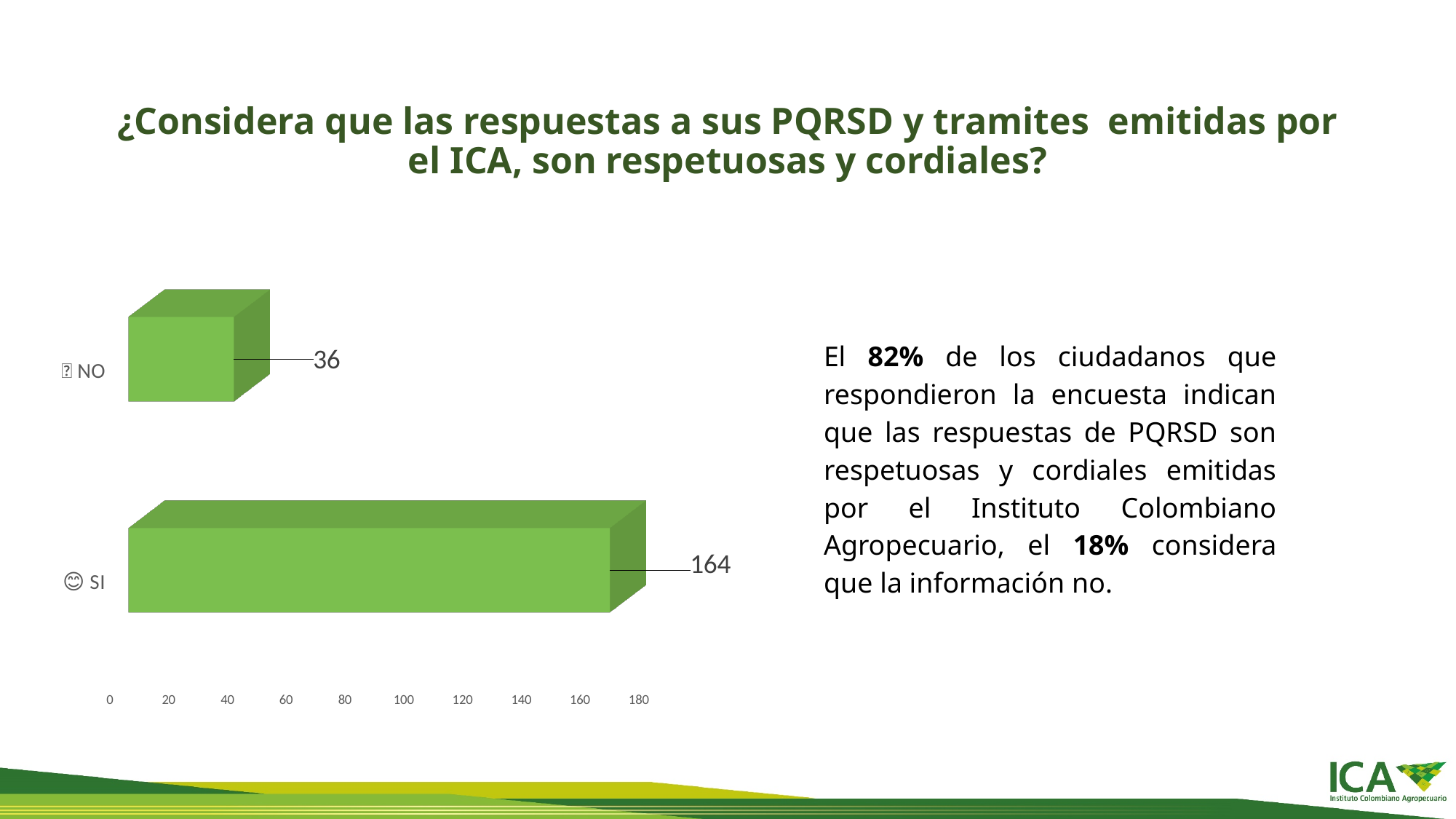
How many categories are shown in the chart? 2 What is the difference between the values for SI and NO? 128 What is the total of the values for SI and NO? 200 Which is larger, the value for SI or the value for NO? SI Which category has the lowest value? NO What is the value for SI? 164 What kind of chart is shown on the slide? bar chart What is the value for NO? 36 What is the highest value shown on the horizontal axis? 180 Is the value for SI greater or less than 100? greater Which category has the highest value? SI Is the value for NO greater or less than 40? less